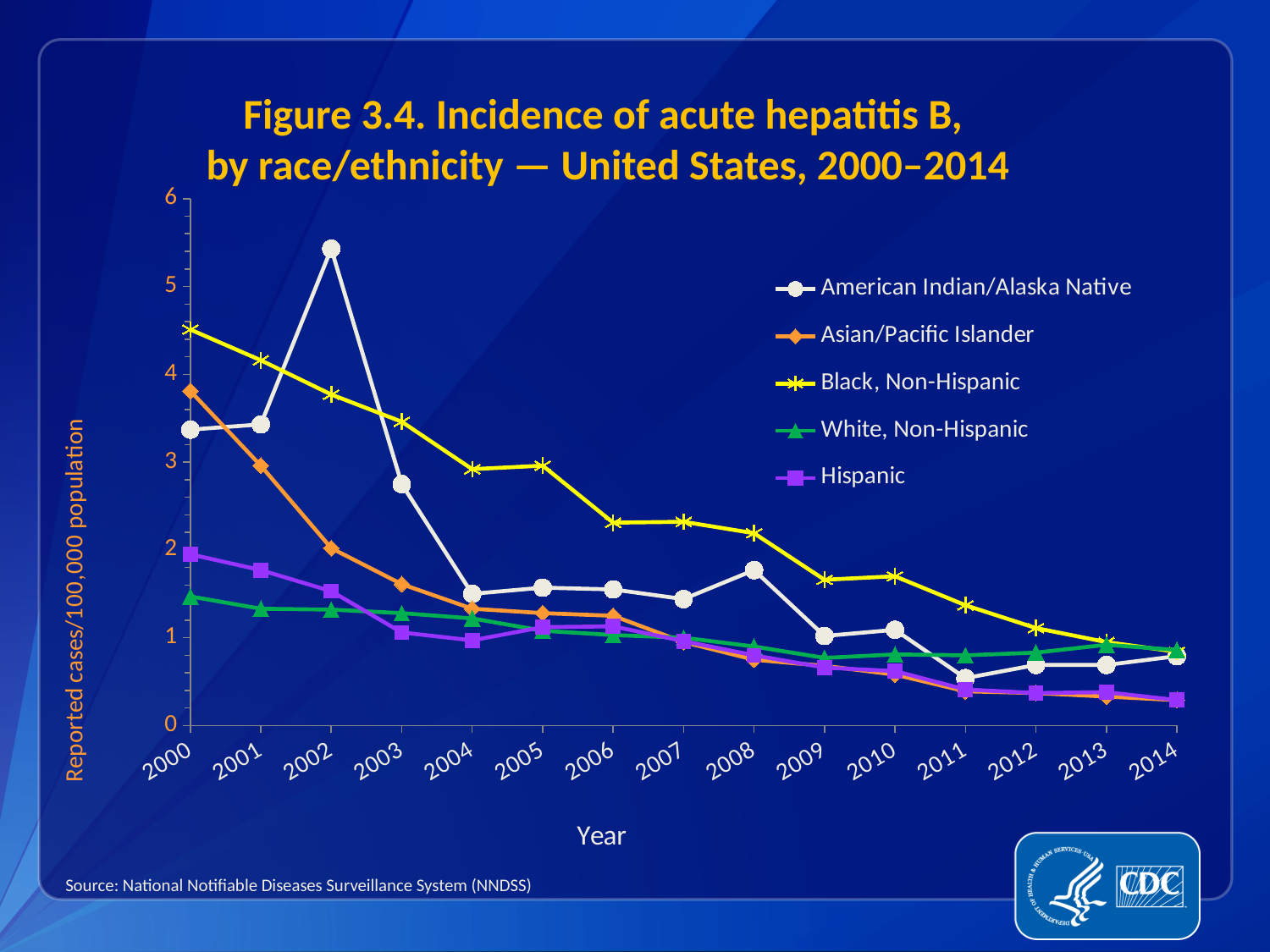
How many years are plotted along the x axis? 15 Is the value for American Indian/Alaska Native in 2002 greater or less than 5? greater Which series has the highest value in 2000? Black, Non-Hispanic Does the Black, Non-Hispanic series rise or fall from 2000 to 2014? fall Is the value for Black, Non-Hispanic in 2000 greater or less than 4? greater How many series does the legend list? 5 In 2014, which is larger: the value for White, Non-Hispanic or the value for Hispanic? White, Non-Hispanic What kind of chart is shown on the slide? line chart Which series has the highest value in 2002? American Indian/Alaska Native In which year does the American Indian/Alaska Native series reach its peak? 2002 Is the value for Hispanic in 2014 greater or less than 1? less Which series has the lowest value in 2000? White, Non-Hispanic